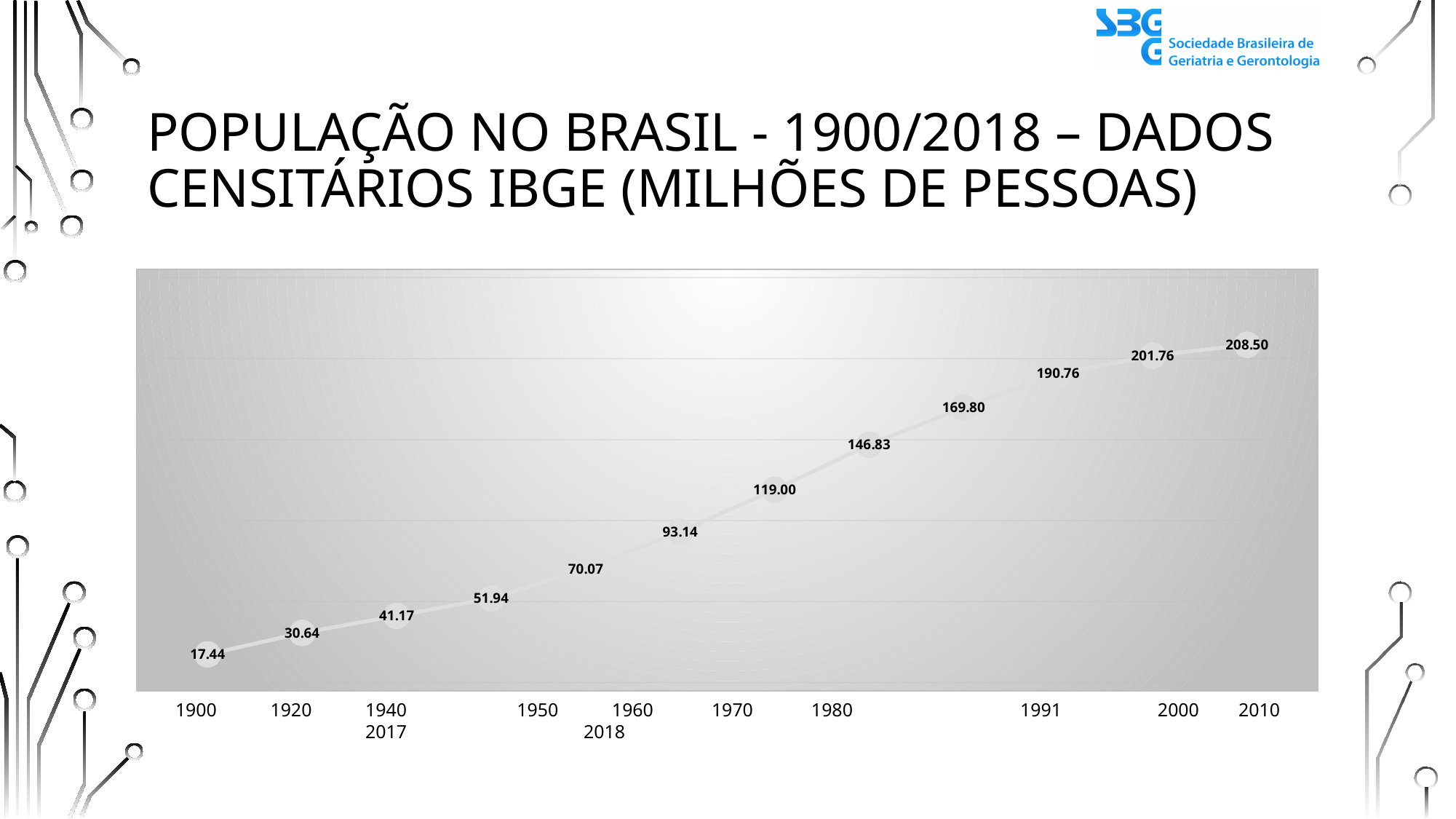
What is the value of the second data point on the line? 30.64 Which is larger, the data point labelled 119.00 or the one labelled 93.14? 119.00 How many data points are plotted on the line? 12 What is the difference between the data points labelled 201.76 and 190.76? 11.00 What kind of chart is shown on the slide? line chart What is the value of the last data point on the line? 208.50 What is the value of the first data point, at 1900? 17.44 What is the difference between the last data point (208.50) and the first data point (17.44)? 191.06 Do the values rise or fall from left to right along the x axis? rise What unit does the chart title say the population values are in? milhões de pessoas What is the lowest value labelled on the chart? 17.44 What is the highest value labelled on the chart? 208.50